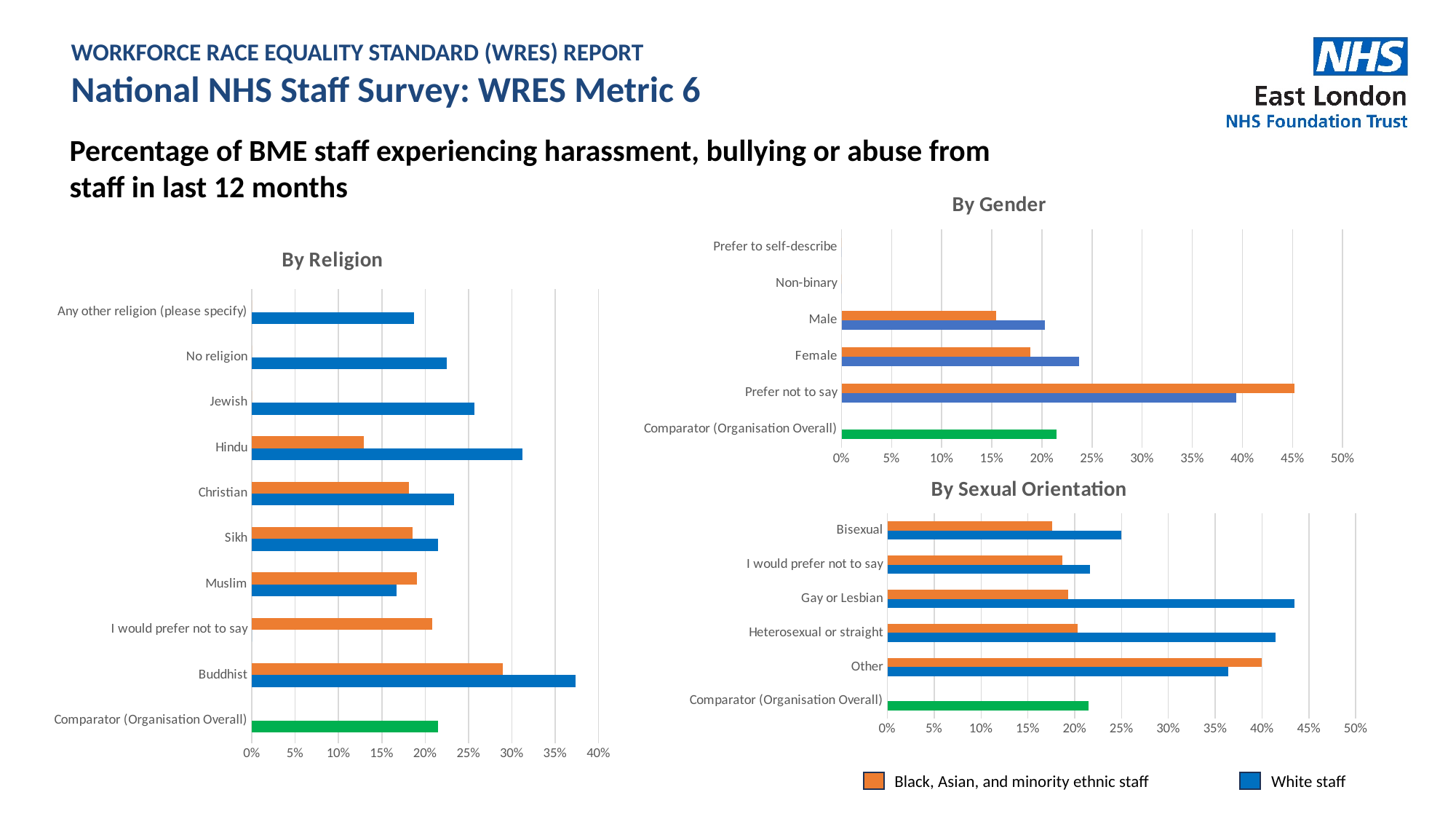
On the 'By Sexual Orientation' chart, which category has the highest value for White staff? Gay or Lesbian On the 'By Religion' chart, which category has the highest value for White staff? Buddhist On the 'By Religion' chart, is the value for Buddhist White staff greater or less than 35%? greater On the 'By Religion' chart, for Muslim, which is larger: the value for Black, Asian, and minority ethnic staff or for White staff? Black, Asian, and minority ethnic staff How many categories are shown on the 'By Religion' chart? 10 On the 'By Sexual Orientation' chart, is the value for Other Black, Asian, and minority ethnic staff greater or less than 35%? greater On the 'By Religion' chart, is the value for Hindu Black, Asian, and minority ethnic staff greater or less than 15%? less On the 'By Gender' chart, which category has the highest value for Black, Asian, and minority ethnic staff? Prefer not to say What kind of chart is the 'By Religion' chart? bar chart How many series does the legend at the bottom of the slide list? 2